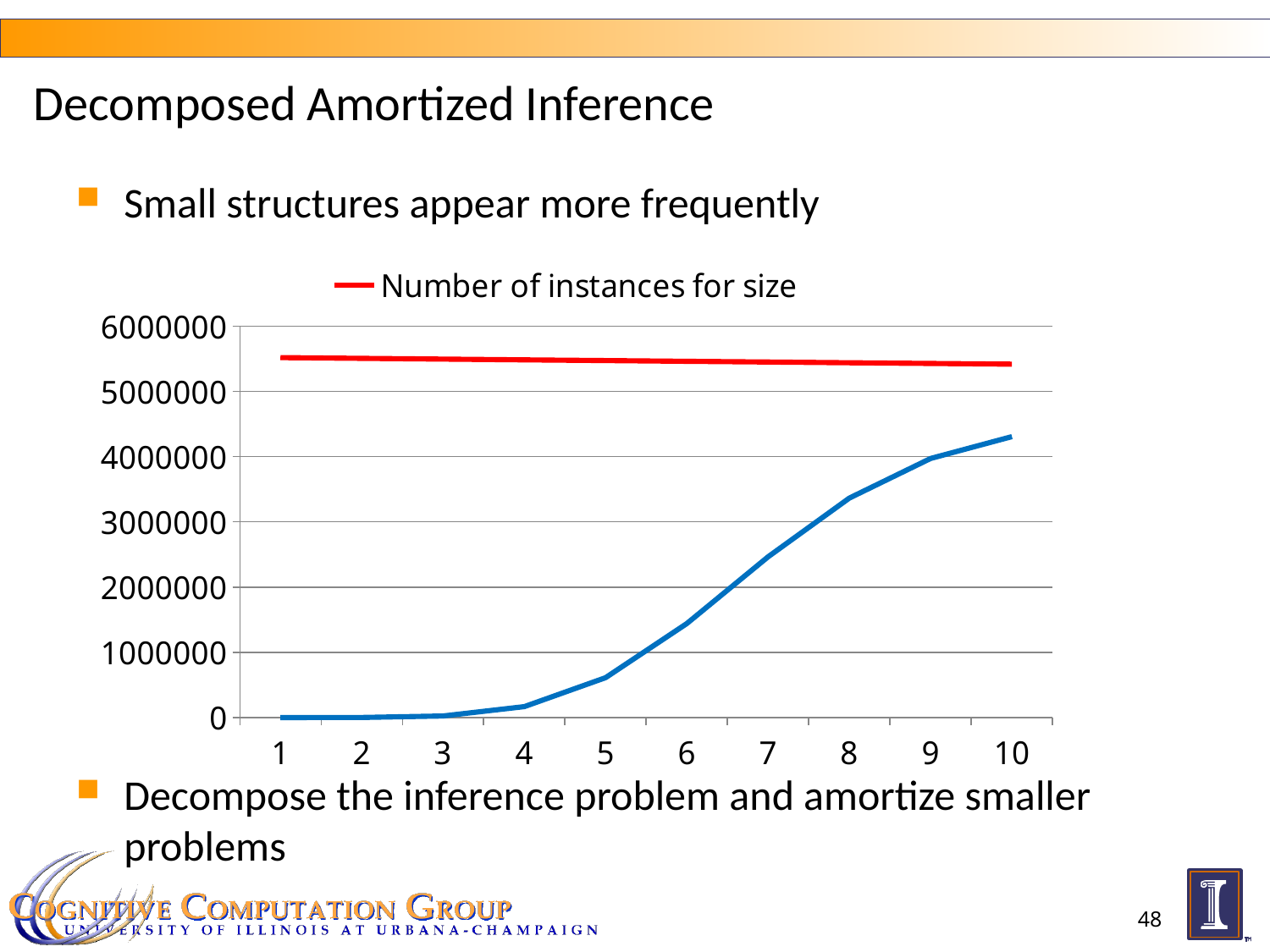
At x = 10, which line has the larger value, the red line or the blue line? red line What is the series name shown in the legend? Number of instances for size What colour is the line labelled "Number of instances for size" in the legend? red Is the value of the red line at x = 1 greater or less than 5000000? greater How many series does the legend list? 1 Is the value of the blue line at x = 5 greater or less than 1000000? less How many points are plotted along the x axis? 10 At which x value does the blue line reach its highest point? 10 Is the value of the blue line at x = 10 greater or less than 4000000? greater Does the blue line rise or fall as x goes from 1 to 10? rises What kind of chart is shown on the slide? line chart